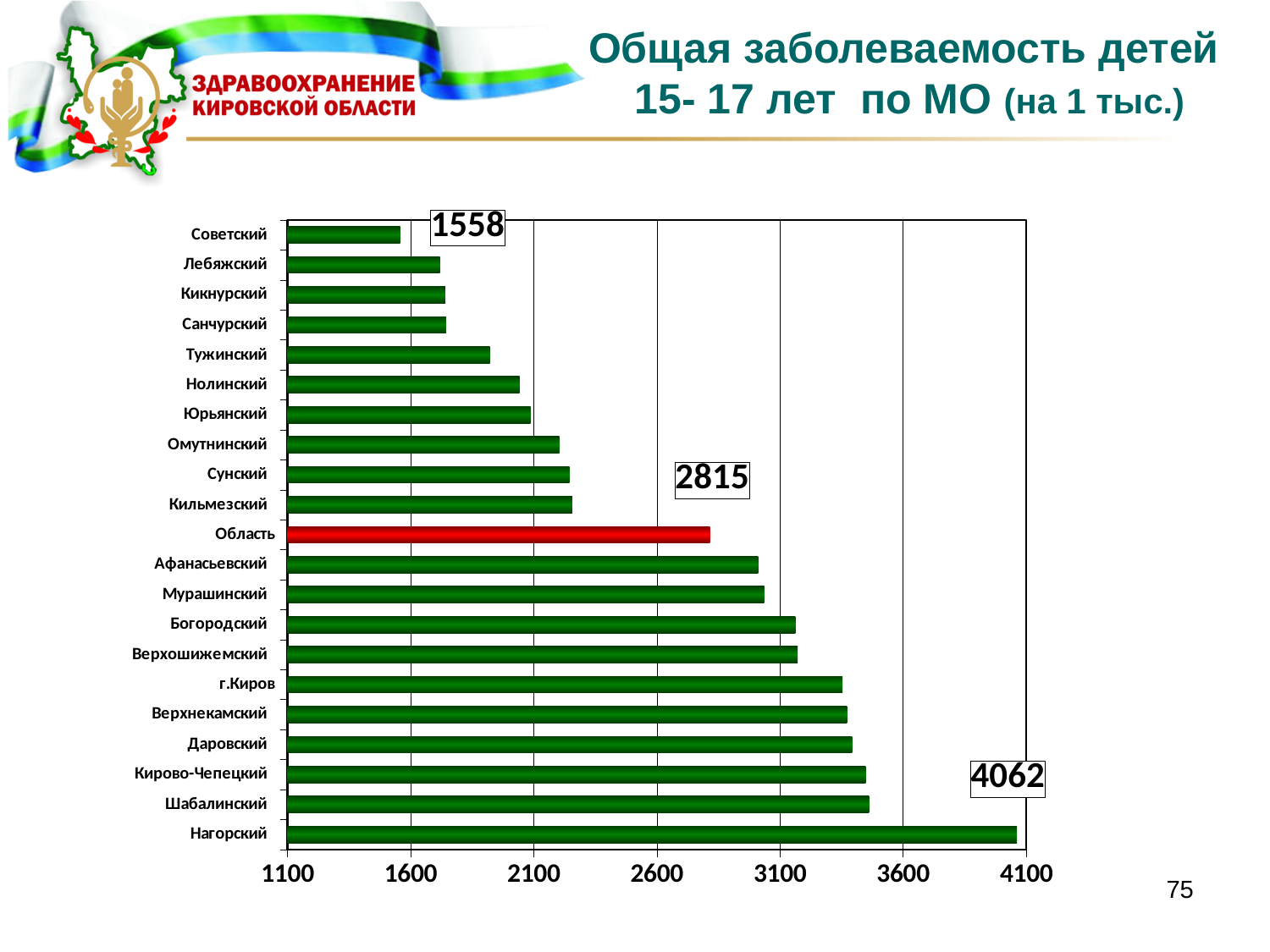
What is the value for Область? 2815 Which is larger, the value for Область or the value for Советский? Область What is the value for Нагорский? 4062 Which category has the lowest value? Советский Is the value for Кирово-Чепецкий greater or less than 3100? greater How many categories are shown on the chart? 21 What is the value for Советский? 1558 Is the value for Тужинский greater or less than 2100? less What is the difference between the values for Нагорский and Советский? 2504 What kind of chart is shown on the slide? bar chart What is the difference between the values for Нагорский and Область? 1247 Which category has the highest value? Нагорский